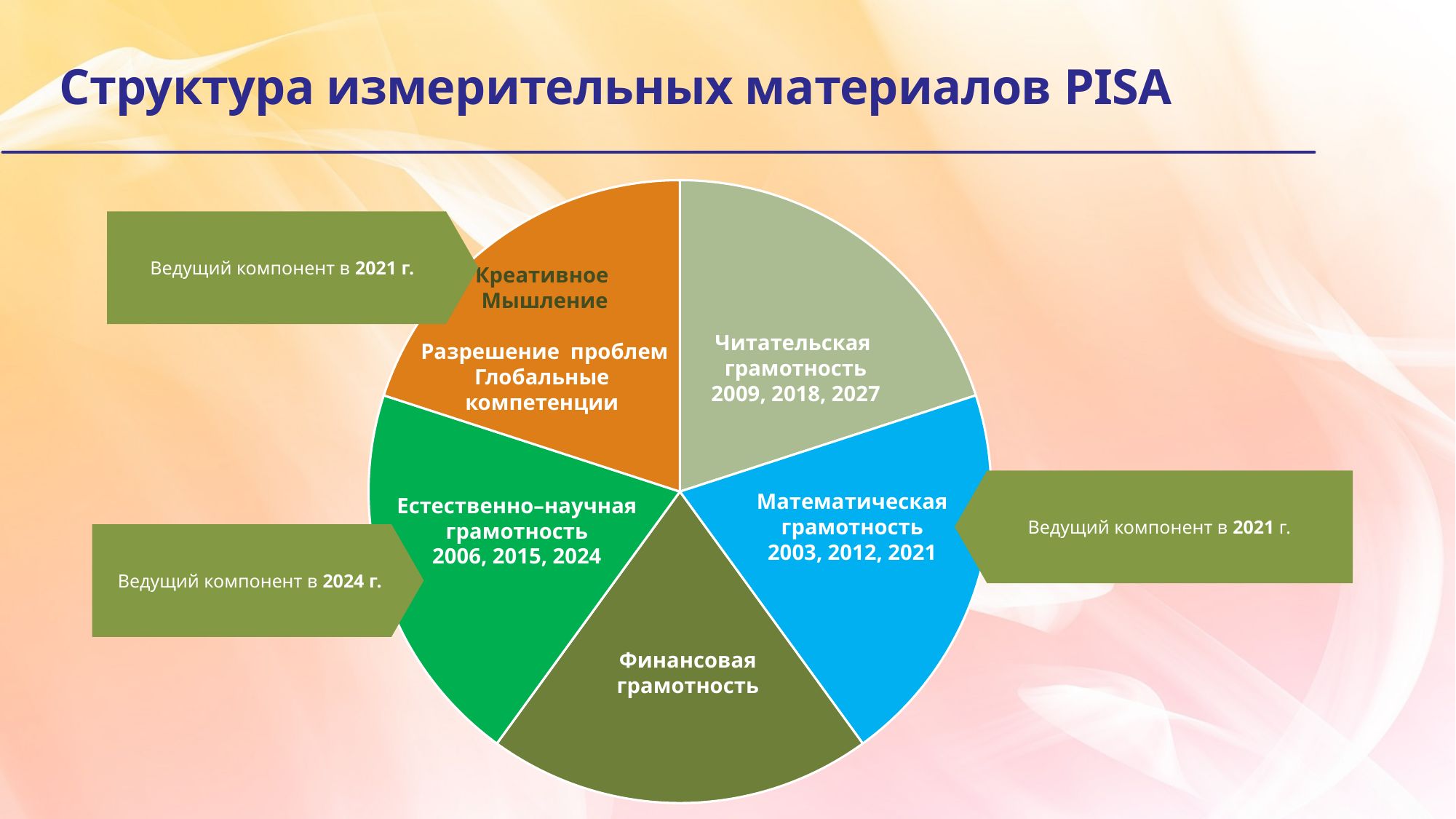
Which years are listed on the slice labelled "Естественно-научная грамотность"? 2006, 2015, 2024 Which years are listed on the slice labelled "Читательская грамотность"? 2009, 2018, 2027 What kind of chart is shown on the slide? Pie chart What colour is the slice labelled "Математическая грамотность"? Blue Which years are listed on the slice labelled "Математическая грамотность"? 2003, 2012, 2021 How many slices does the pie chart have? 5 What is the title of the slide containing the pie chart? Структура измерительных материалов PISA Which slice of the pie chart is coloured orange? Креативное мышление / Разрешение проблем / Глобальные компетенции According to the callout next to the pie chart, in which year is "Естественно-научная грамотность" the leading component? 2024